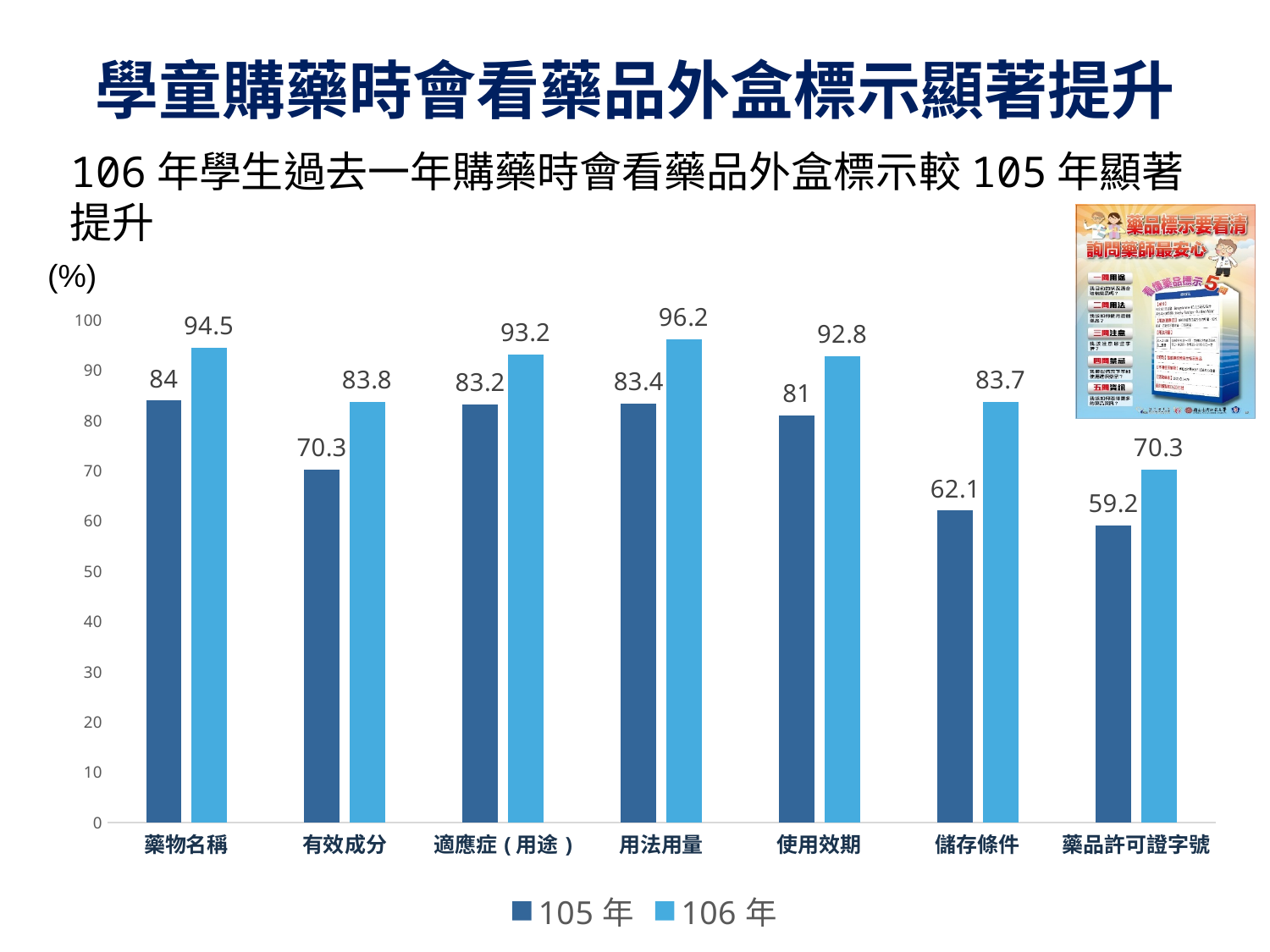
What is the value for 用法用量 in the 106 年 series? 96.2 Which is larger: the 105 年 value for 使用效期 or the 105 年 value for 有效成分? 使用效期 What kind of chart is shown on the slide? bar chart How many series does the legend list? 2 What is the value for 儲存條件 in the 105 年 series? 62.1 Is the 106 年 value for 藥品許可證字號 greater or less than 80? less Which category has the highest value in the 106 年 series? 用法用量 Which category has the lowest value in the 105 年 series? 藥品許可證字號 What is the difference between the 106 年 and 105 年 values for 儲存條件? 21.6 How many categories are shown on the x axis? 7 What is the value for 藥物名稱 in the 105 年 series? 84 What unit is shown on the y axis label? (%)